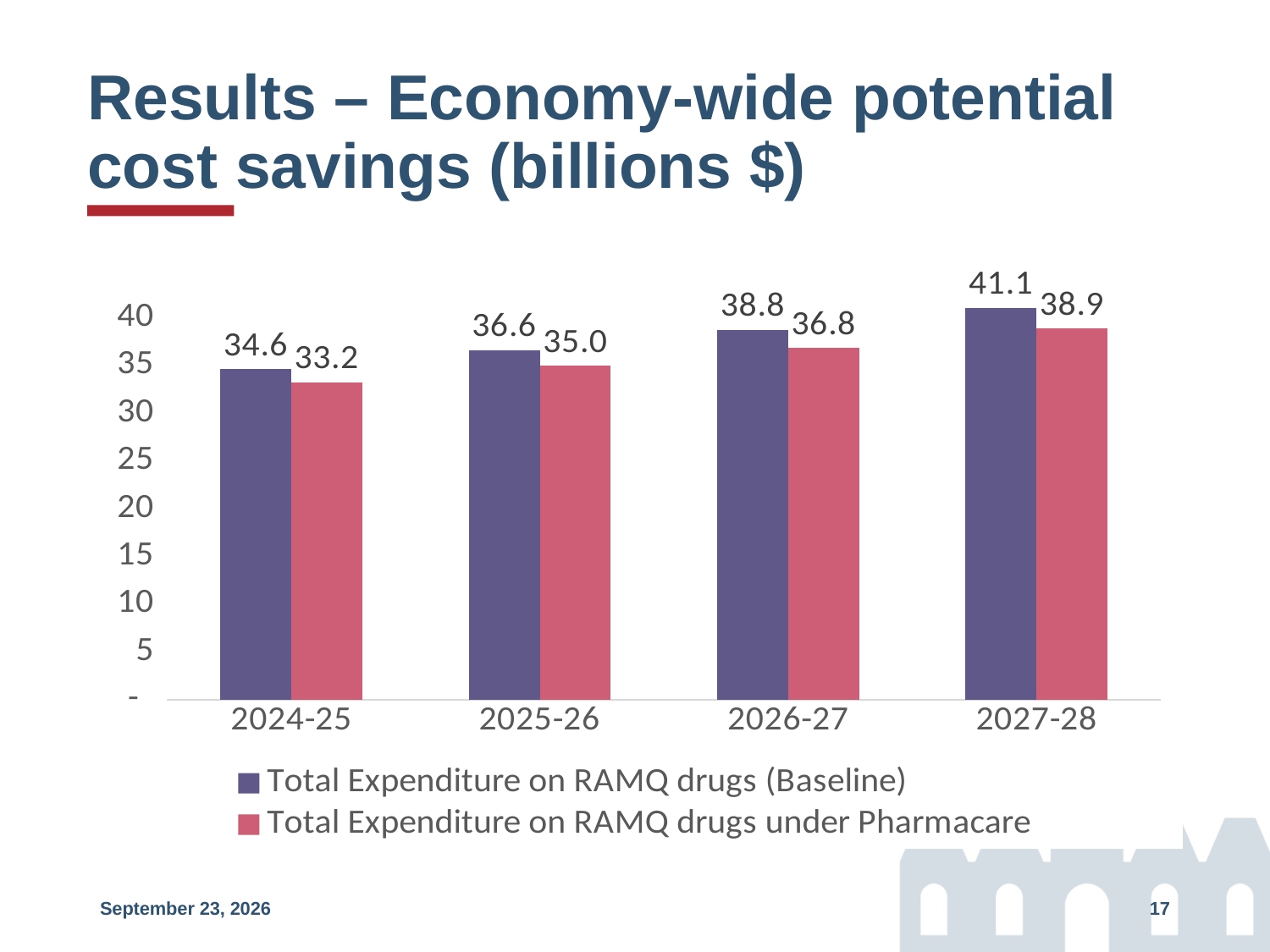
What is the Total Expenditure on RAMQ drugs (Baseline) for 2024-25? 34.6 In which year is the Total Expenditure on RAMQ drugs (Baseline) highest? 2027-28 How many series does the legend list? 2 What kind of chart is shown on the slide? Bar chart What is the Total Expenditure on RAMQ drugs under Pharmacare for 2026-27? 36.8 Which is larger in 2026-27: the Baseline expenditure or the expenditure under Pharmacare? Baseline What is the difference between the Baseline and Pharmacare expenditure in 2025-26? 1.6 Does the Total Expenditure on RAMQ drugs under Pharmacare rise or fall from 2024-25 to 2027-28? Rise What is the difference between the Baseline expenditure in 2027-28 and in 2024-25? 6.5 What is the Total Expenditure on RAMQ drugs under Pharmacare for 2027-28? 38.9 In which year is the Total Expenditure on RAMQ drugs under Pharmacare lowest? 2024-25 How many years are shown on the x axis? 4